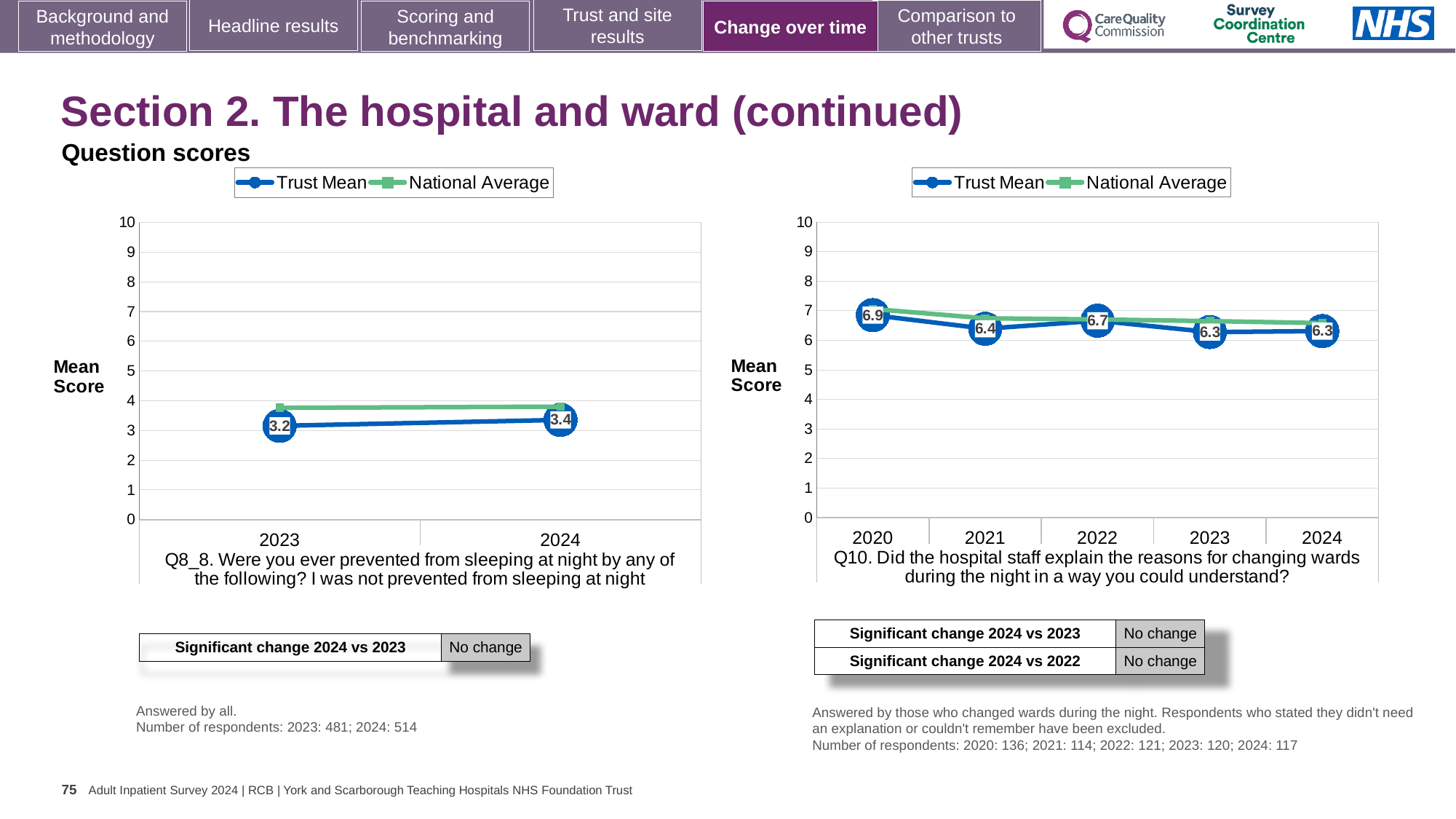
In the right chart (Q10), what is the Trust Mean score for 2020? 6.9 How many series does the legend of the left chart list? 2 In the right chart (Q10), which year has the highest Trust Mean score? 2020 In the right chart (Q10), how many years are plotted on the x axis? 5 In the left chart (Q8_8), what is the Trust Mean score for 2024? 3.4 In the right chart (Q10), what is the Trust Mean score for 2022? 6.7 What type of chart is used for Q10 on the right of the slide? Line chart In the right chart (Q10), is the Trust Mean higher in 2021 or in 2022? 2022 In the left chart (Q8_8), by how much did the Trust Mean change from 2023 to 2024? 0.2 In the right chart (Q10), what is the difference between the Trust Mean in 2020 and in 2024? 0.6 In the left chart (Q8_8), what is the Trust Mean score for 2023? 3.2 In the left chart (Q8_8), is the National Average for 2024 greater or less than 3? greater